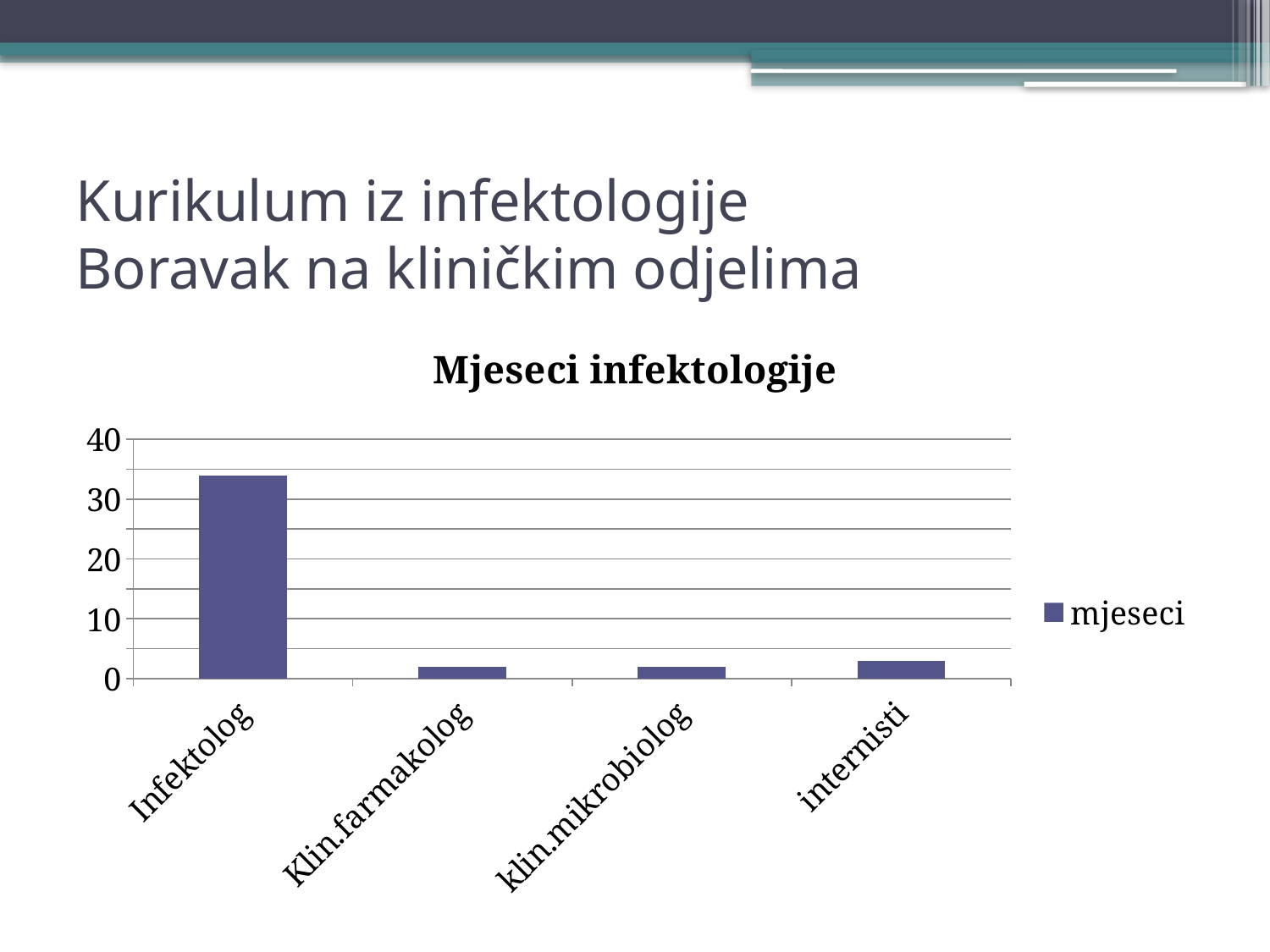
What is the title of the chart? Mjeseci infektologije How many categories are shown on the x axis of the chart? 4 What kind of chart is shown on the slide? bar chart Is the value for Infektolog greater or less than 30? greater What is the name of the series shown in the legend? mjeseci Which category has the highest value? Infektolog Is the value for internisti greater or less than 10? less Is the value for Klin.farmakolog greater or less than 10? less Which is larger, the value for Infektolog or the value for internisti? Infektolog Which is larger, the value for Infektolog or the value for Klin.farmakolog? Infektolog How many series does the legend list? 1